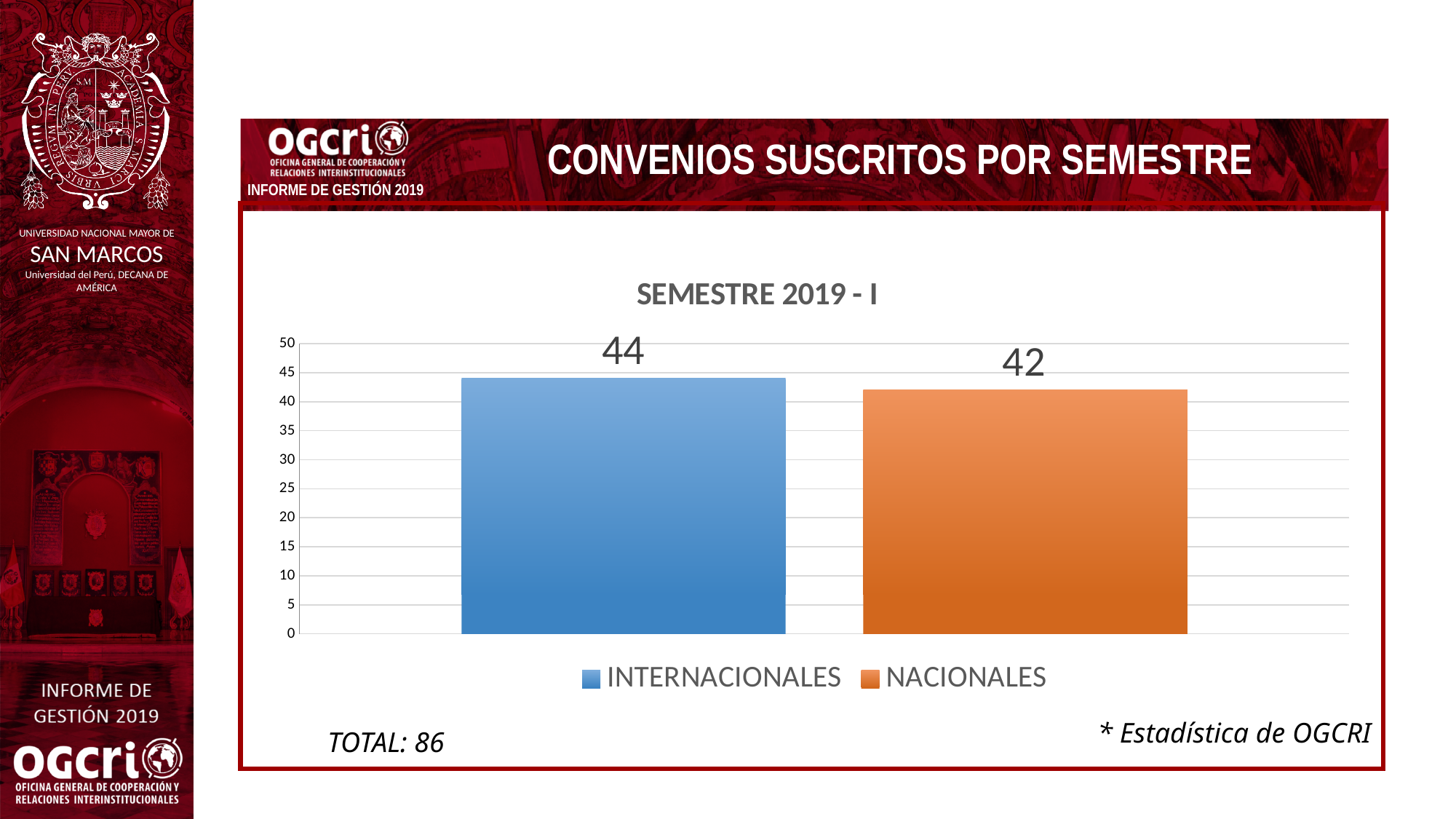
Which series has the lowest value? NACIONALES What is the value for INTERNACIONALES? 44 What is the value for NACIONALES? 42 How many series does the legend list? 2 What kind of chart is shown? bar chart What is the total of the two values shown in the chart? 86 Which series has the highest value? INTERNACIONALES What is the title of the chart? SEMESTRE 2019 - I Is the value for NACIONALES greater or less than 40? greater What colour is the NACIONALES bar? orange What is the difference between the INTERNACIONALES and NACIONALES values? 2 Which is larger, INTERNACIONALES or NACIONALES? INTERNACIONALES